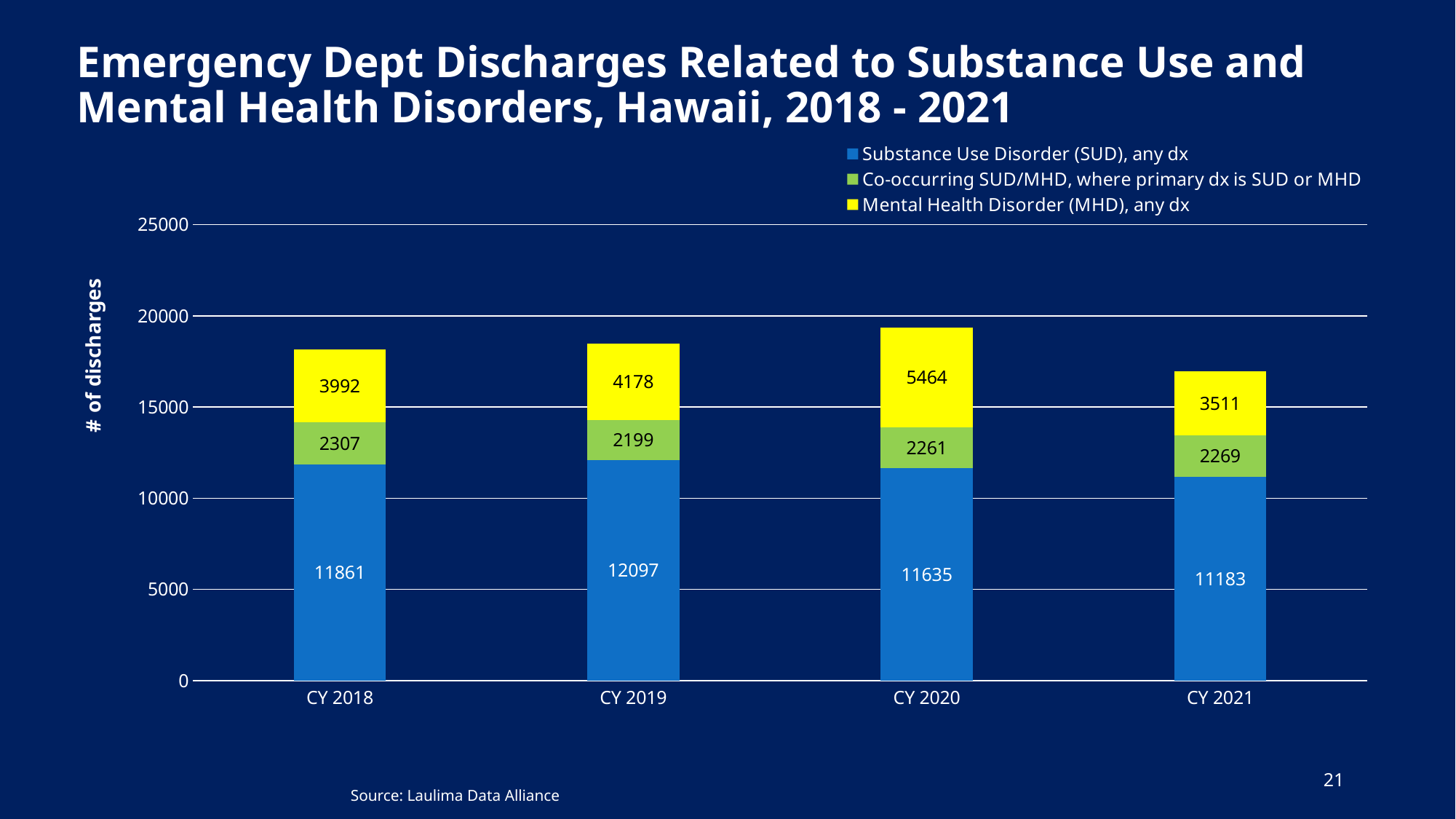
In which year is the Substance Use Disorder (SUD), any dx value lowest? CY 2021 What is the difference between the Mental Health Disorder (MHD), any dx values for CY 2020 and CY 2019? 1286 What is the number of Substance Use Disorder (SUD), any dx discharges in CY 2019? 12097 In which year is the Mental Health Disorder (MHD), any dx value highest? CY 2020 What is the number of Mental Health Disorder (MHD), any dx discharges in CY 2020? 5464 What is the number of Co-occurring SUD/MHD discharges in CY 2021? 2269 Which is larger: the Substance Use Disorder (SUD), any dx value for CY 2018 or for CY 2020? CY 2018 What is the total number of discharges for the CY 2020 stacked bar? 19360 How many series does the legend list? 3 How many years (categories) are shown on the x axis? 4 What kind of chart is shown on the slide? Stacked bar chart What is the total number of discharges for the CY 2021 stacked bar? 16963